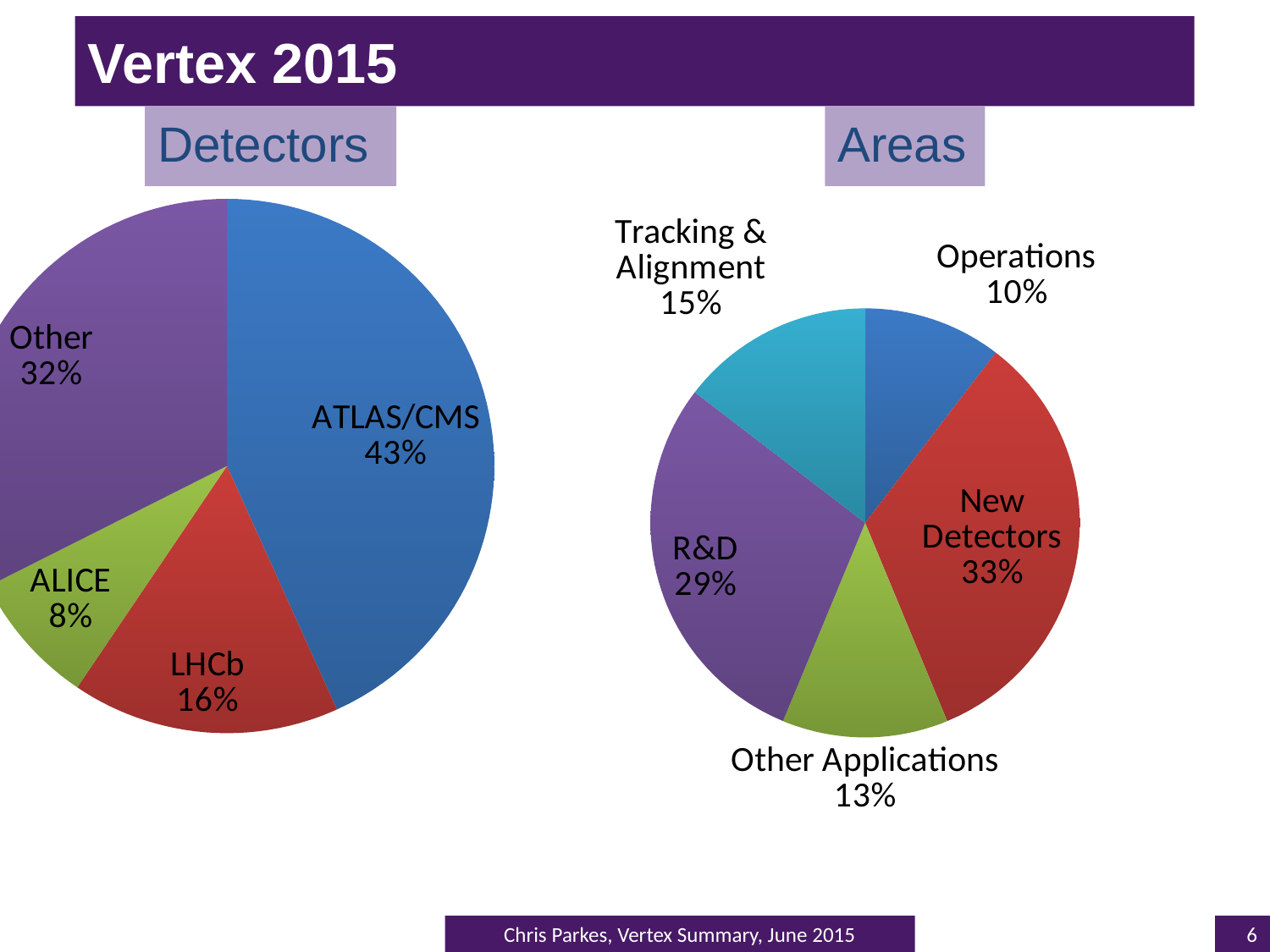
In the Detectors pie chart, what is the difference between the ATLAS/CMS share and the Other share? 11% In the Detectors pie chart, what share does LHCb have? 16% In the Detectors pie chart, which category has the smallest share? ALICE In the Areas pie chart, which is larger: Other Applications or Tracking & Alignment? Tracking & Alignment In the Areas pie chart, which category has the largest share? New Detectors In the Detectors pie chart, what share does ATLAS/CMS have? 43% In the Detectors pie chart, how many slices are there? 4 In the Areas pie chart, what share does Tracking & Alignment have? 15% In the Areas pie chart, which category has the smallest share? Operations What kind of chart is used for the Areas chart? Pie chart In the Detectors pie chart, which category has the largest share? ATLAS/CMS In the Areas pie chart, what share does R&D have? 29%